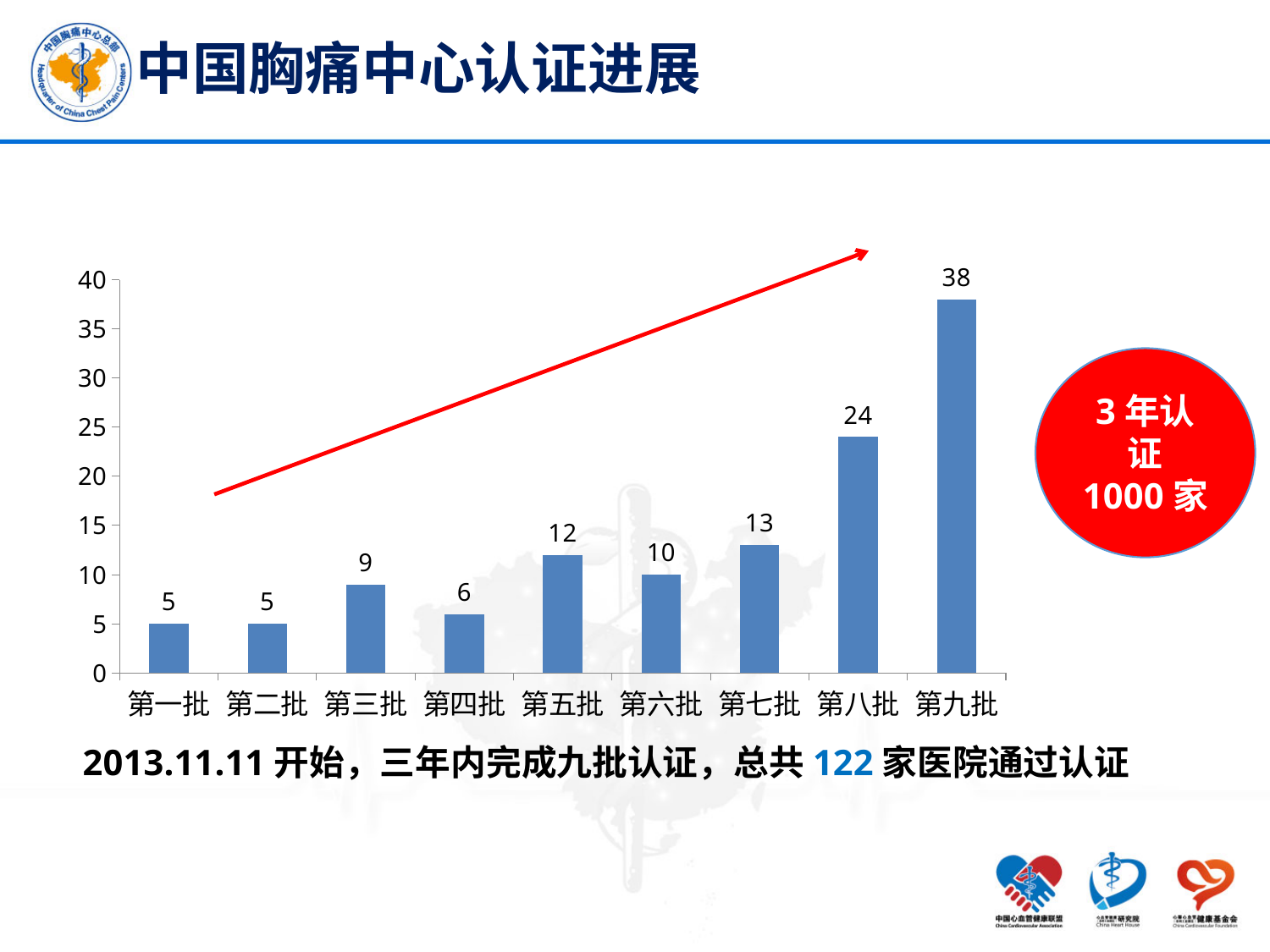
How many batches (categories) are shown on the x axis? 9 What is the difference between the values for 第九批 and 第八批? 14 What is the value for 第五批? 12 What is the lowest value shown on the chart? 5 Is the value for 第八批 greater or less than 20? greater What is the maximum value shown on the y axis? 40 Do the values generally rise or fall from 第一批 to 第九批? rise Which is larger, the value for 第六批 or the value for 第七批? 第七批 What is the value for 第四批? 6 Which batch has the highest value? 第九批 What kind of chart is shown on the slide? bar chart What is the value for 第九批? 38